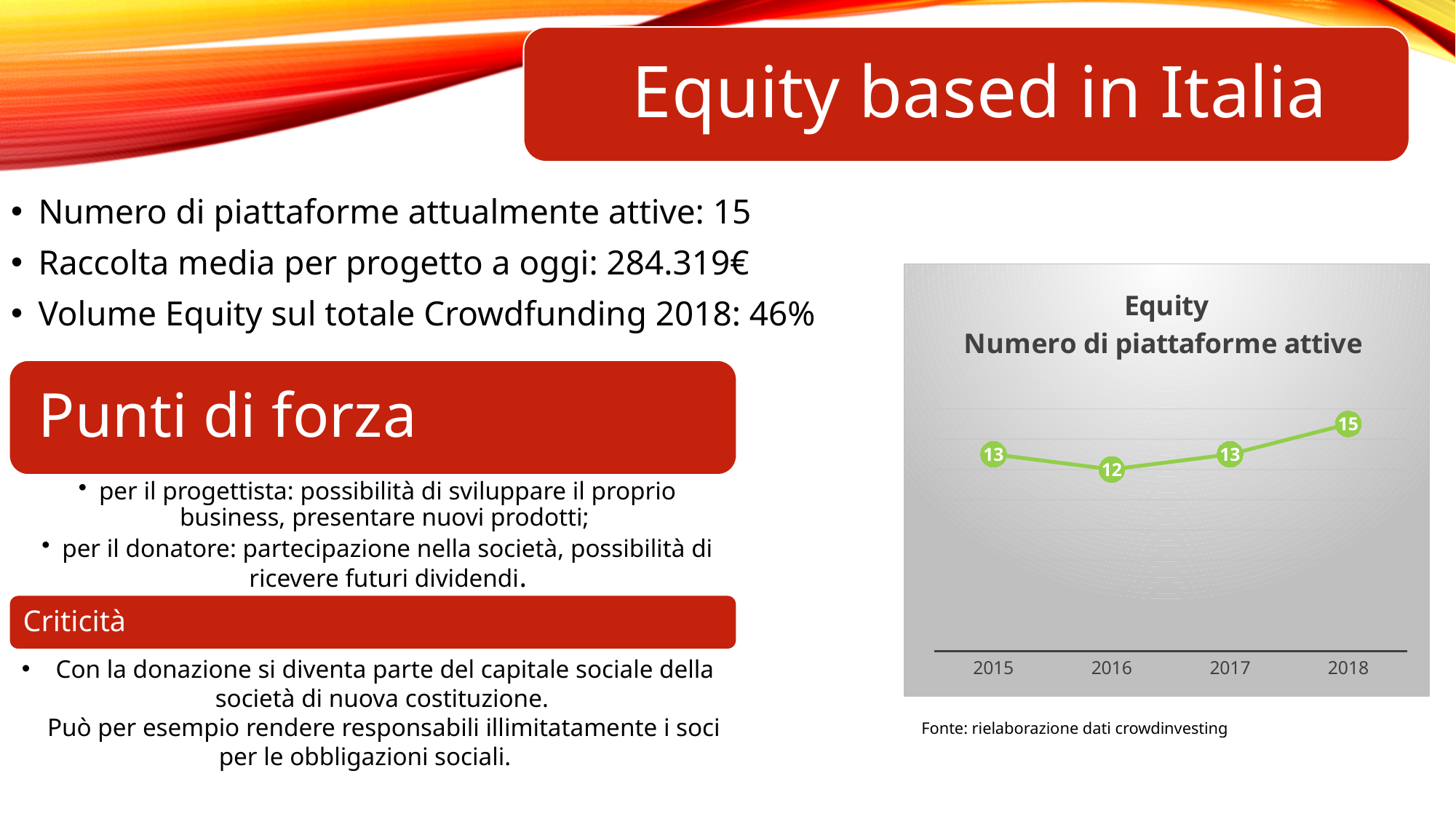
How many years are plotted on the chart? 4 What kind of chart is shown on the slide? Line chart Which year has more active platforms, 2017 or 2018? 2018 What is the number of active platforms shown for 2018? 15 Which year has the highest number of active platforms? 2018 What is the number of active platforms shown for 2016? 12 What is the title of the chart? Equity Numero di piattaforme attive What is the difference between the number of active platforms in 2018 and in 2016? 3 What is the number of active platforms shown for 2017? 13 Which year has the lowest number of active platforms? 2016 What is the number of active platforms shown for 2015? 13 Does the number of active platforms rise or fall from 2016 to 2018? Rise